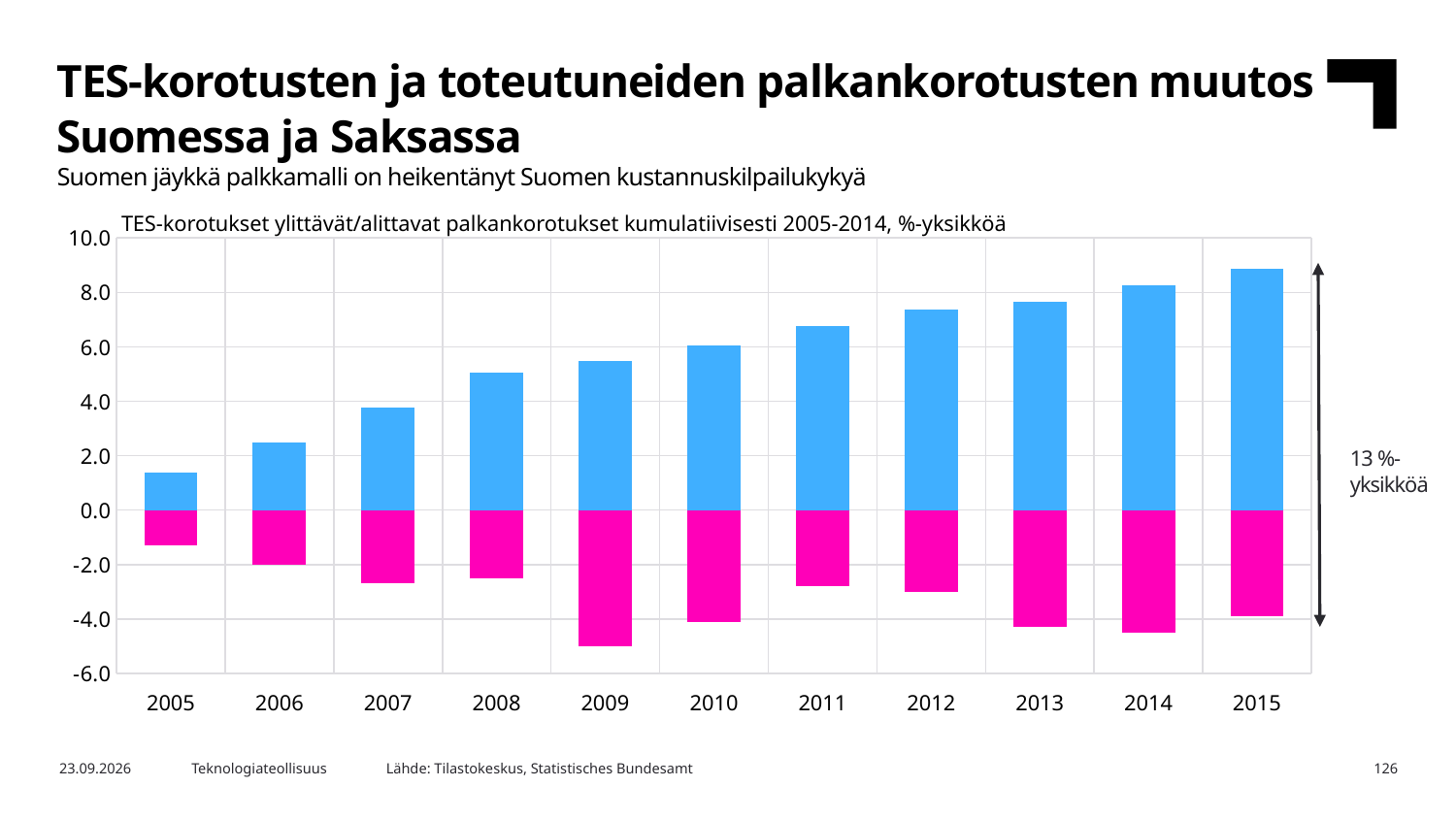
How many years are shown on the x axis of the chart? 11 Is the magenta bar value for 2009 greater or less than -4.0? less Which year has the tallest blue (positive) bar? 2015 Is the blue bar value for 2015 greater or less than 8.0? greater What value does the annotation with the arrow to the right of the chart state? 13 %-yksikköä Which year has the taller blue bar, 2008 or 2013? 2013 Which year has the longest magenta (negative) bar? 2009 Do the blue bars rise or fall from 2005 to 2015? rise What kind of chart is shown on the slide? bar chart Which year has the shortest blue (positive) bar? 2005 Is the blue bar value for 2012 greater or less than 7.0? greater